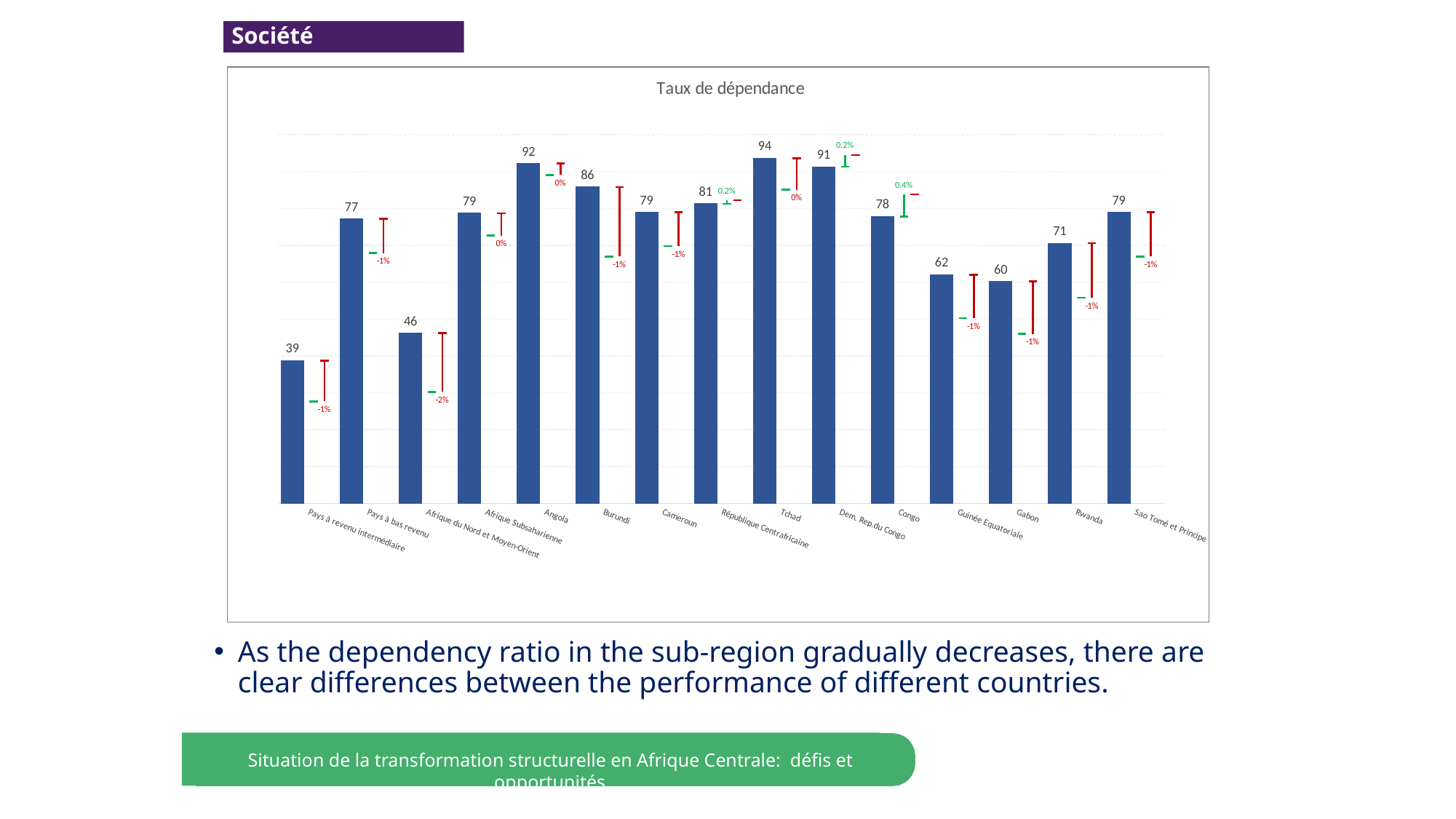
What kind of chart is shown on the slide? Bar chart What value is shown for Angola? 92 What is the dependency ratio value shown for Tchad? 94 Which is larger, the value for Guinée Equatoriale or the value for Gabon? Guinée Equatoriale What is the difference between the values for Burundi and Rwanda? 15 Which category has the highest bar? Tchad What is the difference between the values for Dem. Rep.du Congo and Congo? 13 How many categories are plotted on the x axis? 15 What value is shown for Gabon? 60 What is the title of the chart? Taux de dépendance What value is shown for Afrique du Nord et Moyen-Orient? 46 Which category has the lowest bar? Pays à revenu intermédiaire